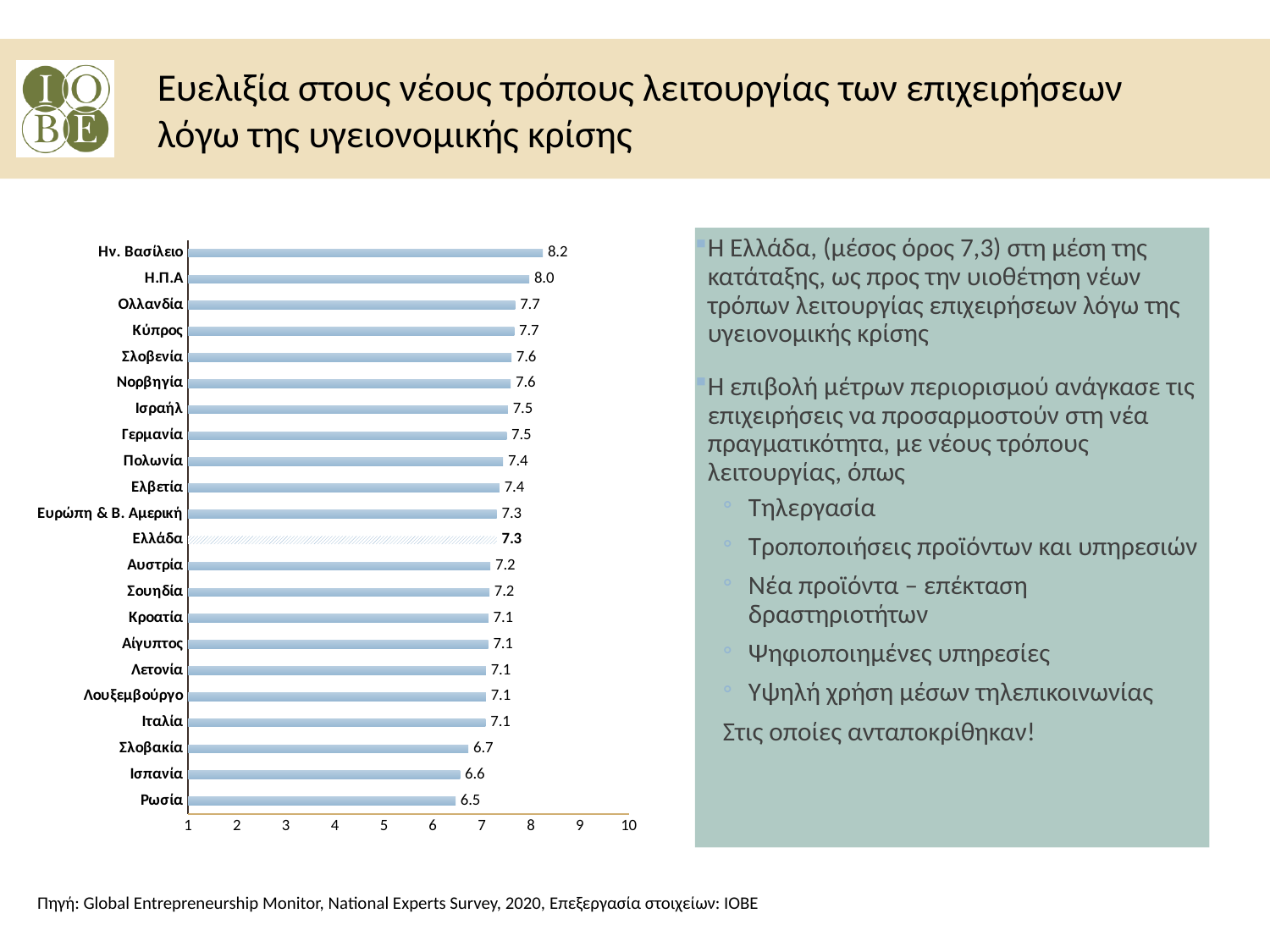
Which category has the lowest value? Ρωσία What value is shown for Ελλάδα? 7.3 What kind of chart is shown on the slide? bar chart What value is shown for Ην. Βασίλειο? 8.2 What is the difference between the values for Ην. Βασίλειο and Ρωσία? 1.7 How many categories are shown in the chart? 22 Which has a larger value, Ολλανδία or Ισπανία? Ολλανδία Which category has the highest value? Ην. Βασίλειο What value is shown for Σλοβακία? 6.7 What value is shown for Ρωσία? 6.5 Is the value for Ισπανία greater or less than 7? less What is the difference between the values for Η.Π.Α and Ελλάδα? 0.7